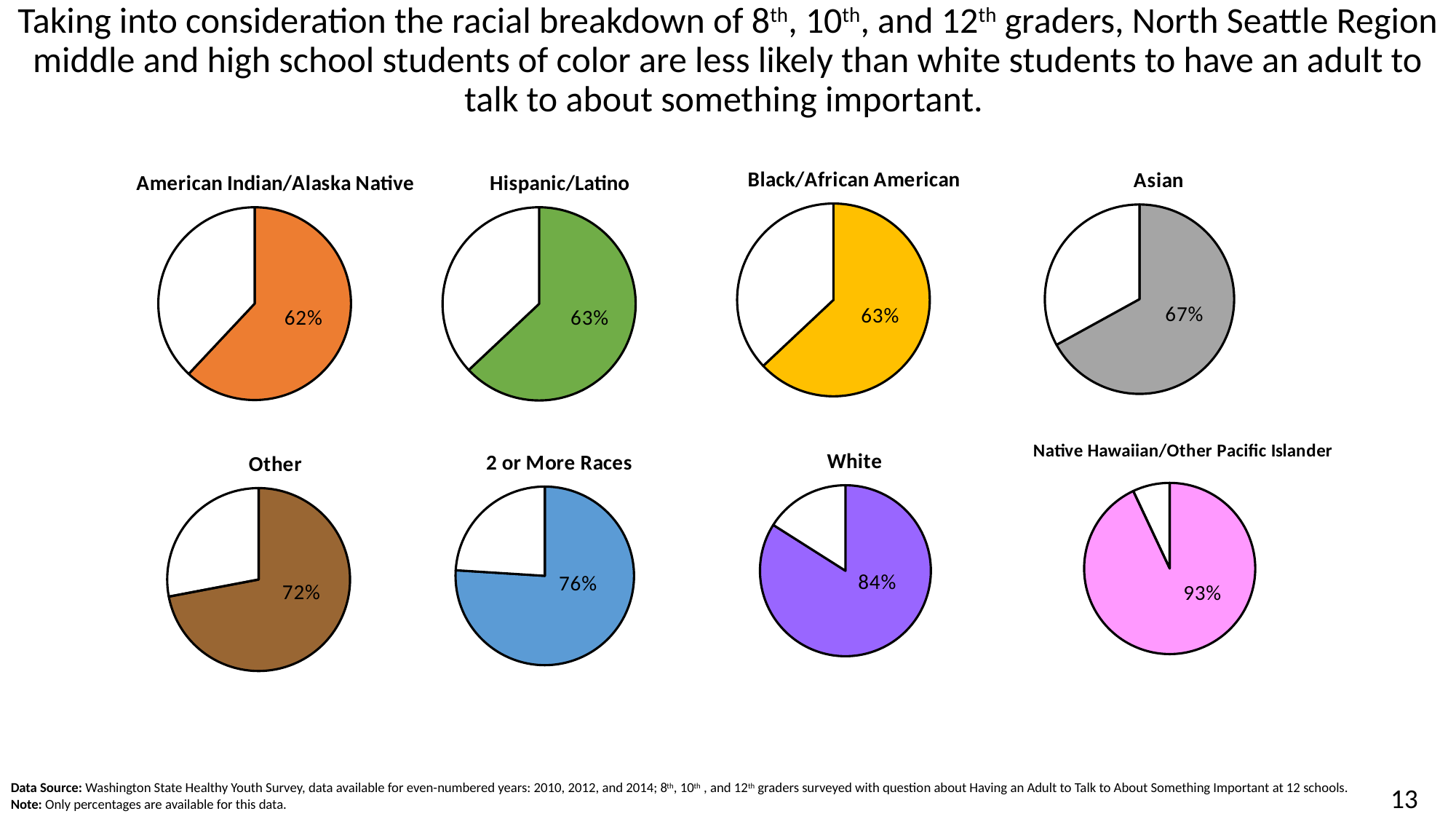
In the American Indian/Alaska Native pie chart, what percentage is shown for the colored slice? 62% In the White pie chart, what percentage is shown for the colored slice? 84% What color is the labeled slice in the 2 or More Races pie chart? Blue What is the difference between the percentage in the White pie chart and the percentage in the Black/African American pie chart? 21% How many pie charts are shown on the slide? 8 In the Native Hawaiian/Other Pacific Islander pie chart, what percentage is shown for the colored slice? 93% Across all the pie charts on the slide, which group has the lowest labeled percentage? American Indian/Alaska Native What kind of chart is used for each racial group on the slide? Pie chart In the Hispanic/Latino pie chart, what percentage is shown for the colored slice? 63% Which is larger: the percentage in the 2 or More Races pie chart or the percentage in the Other pie chart? 2 or More Races Across all the pie charts on the slide, which group has the highest labeled percentage? Native Hawaiian/Other Pacific Islander In the Asian pie chart, what percentage is shown for the colored slice? 67%